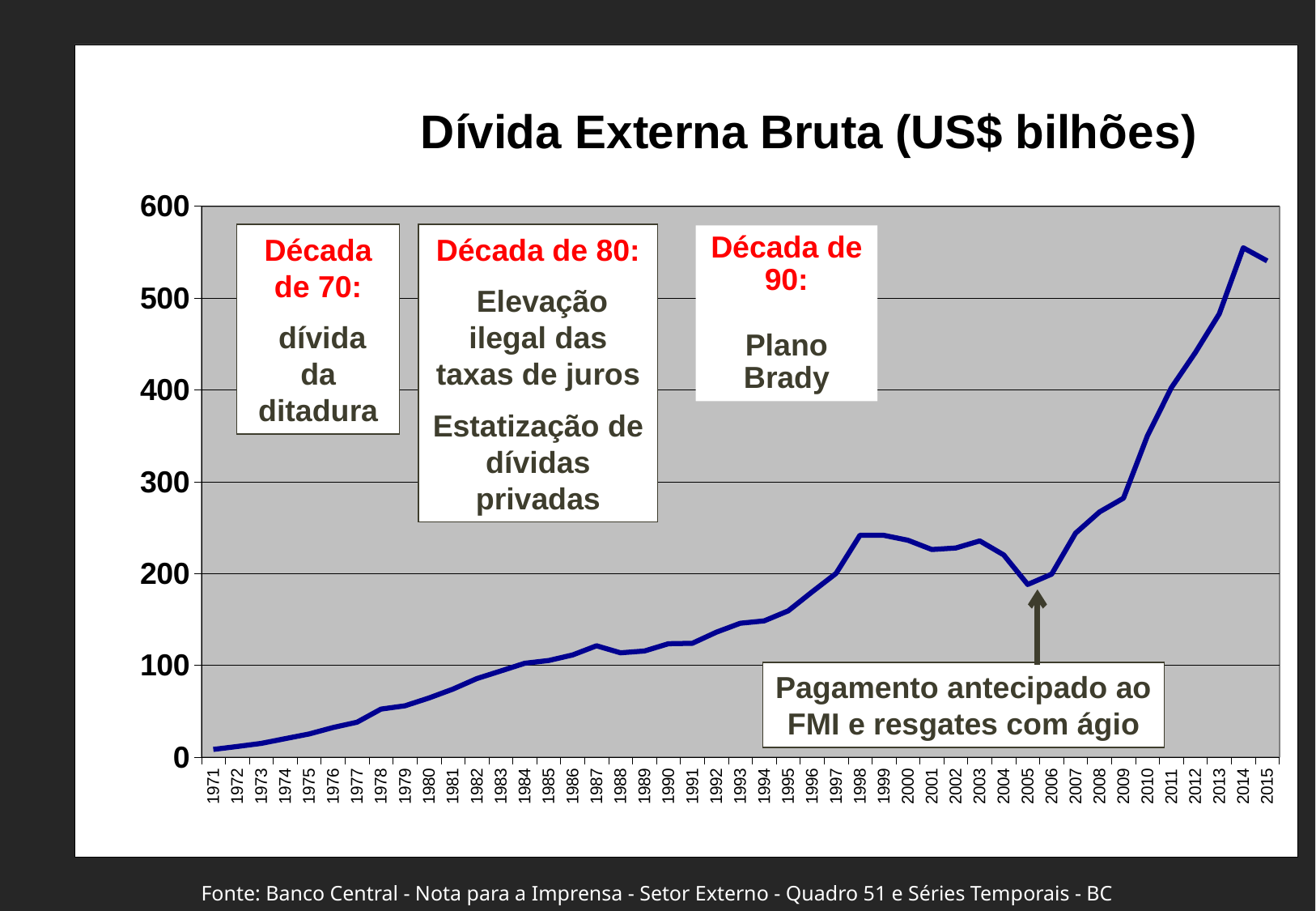
Which year has the larger value, 2003 or 2005? 2003 How many years are plotted along the x axis of the chart? 45 In which year does the line reach its highest value? 2014 Is the value for 1971 greater or less than 100? less Which event does the arrow annotation near 2005 point to? Pagamento antecipado ao FMI e resgates com ágio In which year is the plotted value lowest? 1971 Overall, does the plotted value rise or fall from 1971 to 2015? rise Is the value for 2014 greater or less than 500? greater What is the title of the chart? Dívida Externa Bruta (US$ bilhões) Is the value for 1998 greater or less than 200? greater What kind of chart is shown on the slide? line chart